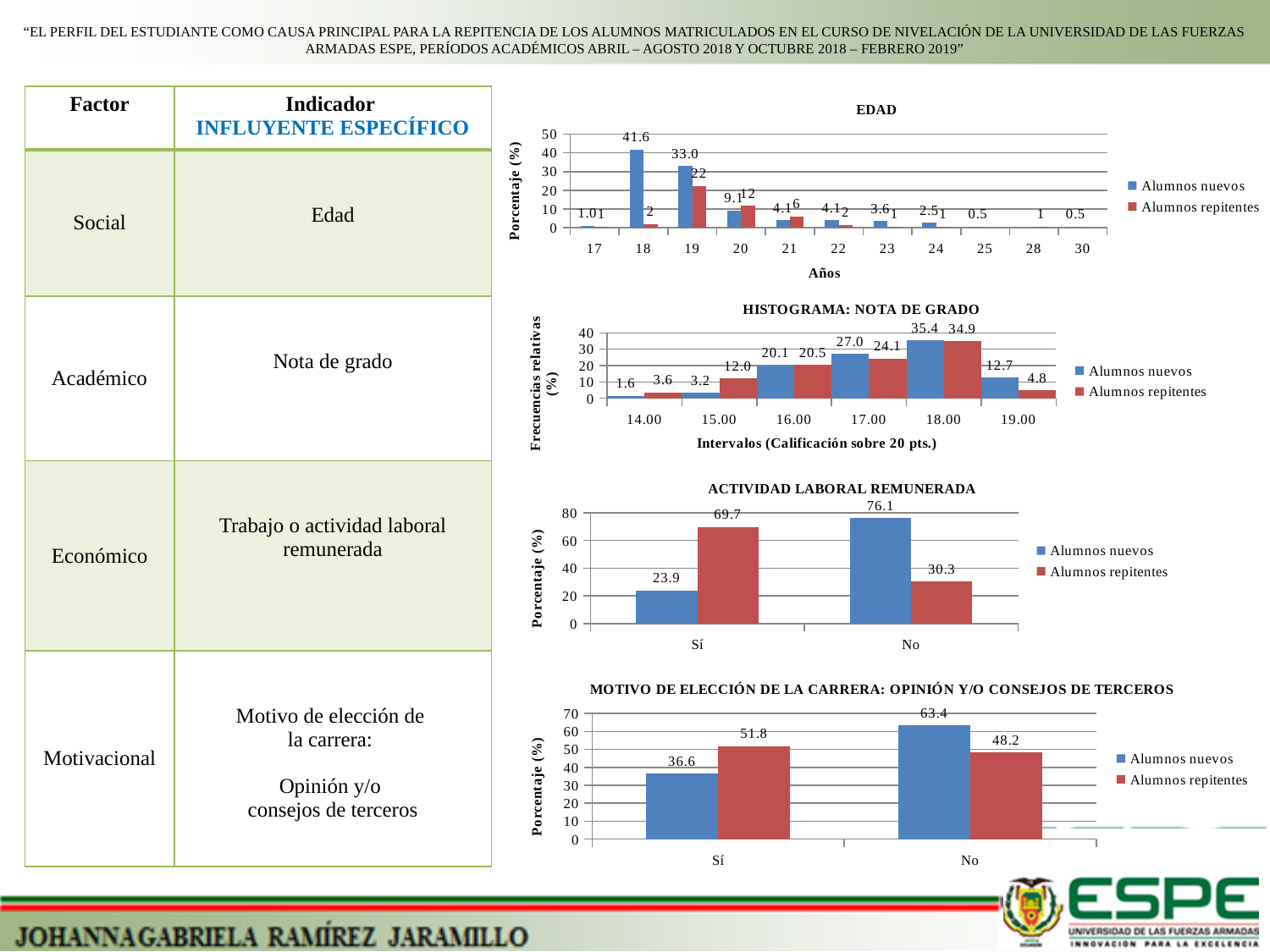
In the ACTIVIDAD LABORAL REMUNERADA chart, what is the difference between Alumnos nuevos and Alumnos repitentes in the No category? 45.8 How many series does the legend of the ACTIVIDAD LABORAL REMUNERADA chart list? 2 In the HISTOGRAMA: NOTA DE GRADO chart, which interval has the lowest value for Alumnos nuevos? 14.00 In the MOTIVO DE ELECCIÓN DE LA CARRERA chart, what is the difference between the Alumnos nuevos values for No and Sí? 26.8 In the EDAD chart, how many age categories are shown on the x axis? 11 In the ACTIVIDAD LABORAL REMUNERADA chart, what is the value for Alumnos repitentes in the No category? 30.3 In the ACTIVIDAD LABORAL REMUNERADA chart, what is the value for Alumnos nuevos in the Sí category? 23.9 In the EDAD chart, which age has the highest value for Alumnos nuevos? 18 In the HISTOGRAMA: NOTA DE GRADO chart, what is the value for Alumnos nuevos in the 18.00 interval? 35.4 In the MOTIVO DE ELECCIÓN DE LA CARRERA chart, what is the value for Alumnos repitentes in the Sí category? 51.8 In the MOTIVO DE ELECCIÓN DE LA CARRERA chart, which series has the larger value in the No category? Alumnos nuevos In the EDAD chart, what is the value for Alumnos nuevos at 18 años? 41.6